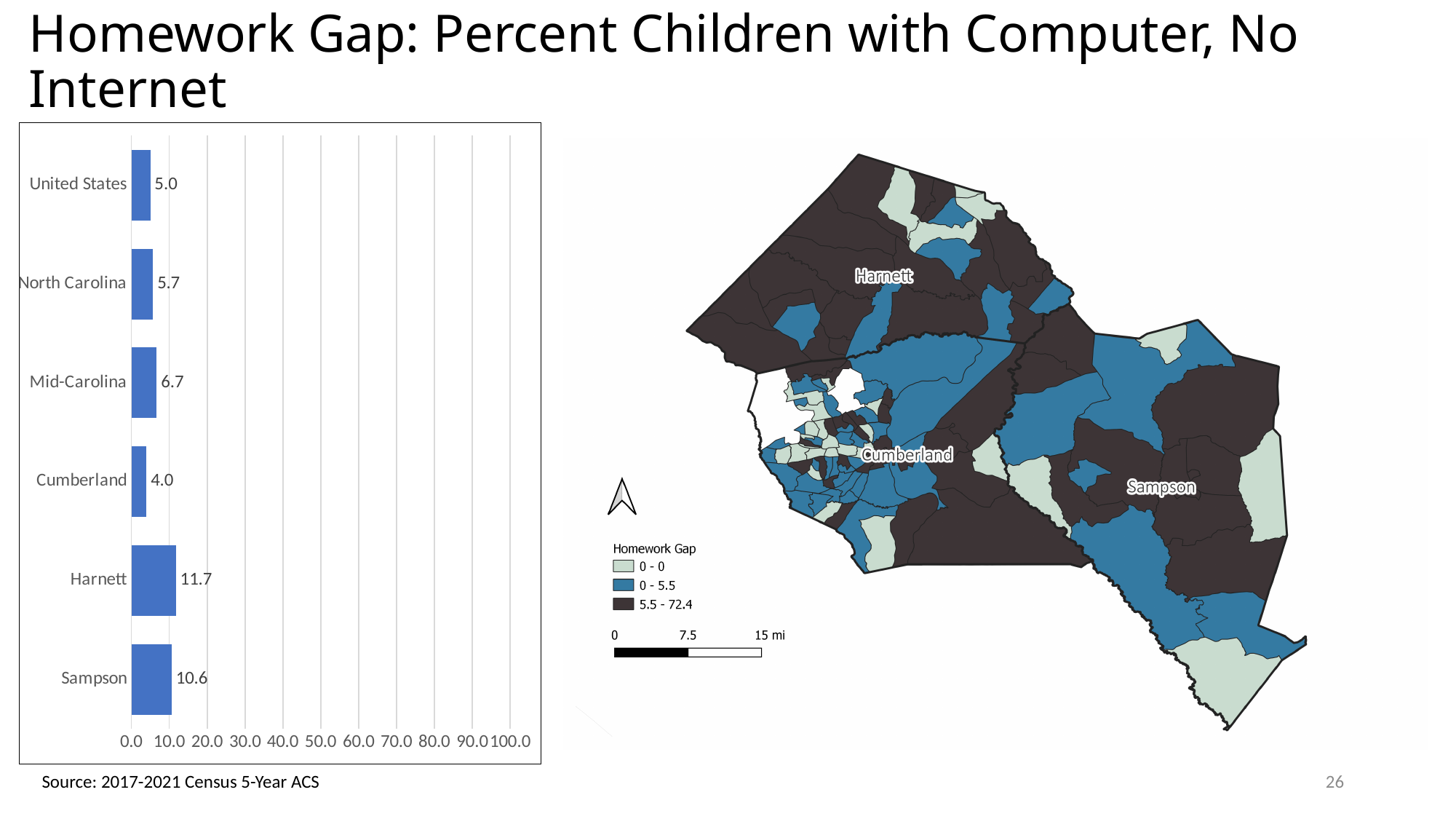
What is the value for Cumberland in the bar chart? 4.0 What kind of chart is on the left side of the slide? Bar chart Which category has the lowest value in the bar chart? Cumberland What is the value for North Carolina in the bar chart? 5.7 How many categories are shown in the bar chart? 6 What is the value for Mid-Carolina in the bar chart? 6.7 Which is larger in the bar chart, the value for Mid-Carolina or the value for Cumberland? Mid-Carolina How many classes does the map legend for Homework Gap list? 3 Which category has the highest value in the bar chart? Harnett What is the difference between the values for Harnett and Sampson in the bar chart? 1.1 What is the value for Harnett in the bar chart? 11.7 What is the difference between the values for North Carolina and the United States in the bar chart? 0.7